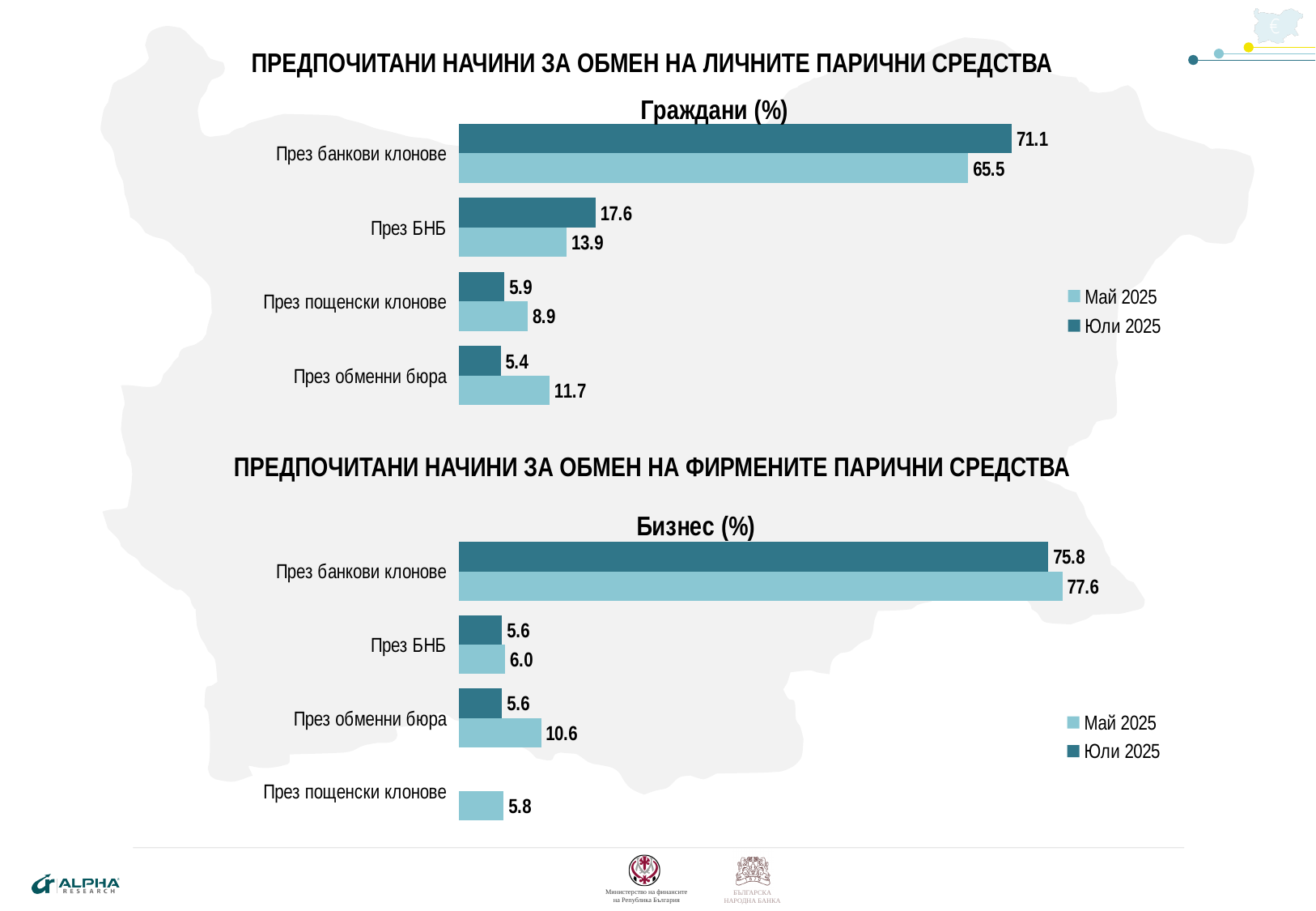
How many series does the legend of the "Бизнес (%)" chart list? 2 What kind of chart is the "Бизнес (%)" chart? Bar chart In the "Граждани (%)" chart, what is the value for "През банкови клонове" in Юли 2025? 71.1 In the "Граждани (%)" chart, which category has the highest value for Юли 2025? През банкови клонове In the "Граждани (%)" chart, which is larger for "През пощенски клонове": Май 2025 or Юли 2025? Май 2025 In the "Бизнес (%)" chart, what is the value for "През банкови клонове" in Май 2025? 77.6 In the "Граждани (%)" chart, what is the value for "През обменни бюра" in Май 2025? 11.7 How many categories are shown in the "Граждани (%)" chart? 4 In the "Бизнес (%)" chart, what is the difference between the Май 2025 and Юли 2025 values for "През обменни бюра"? 5.0 In the "Бизнес (%)" chart, what is the value for "През пощенски клонове" in Май 2025? 5.8 In the "Граждани (%)" chart, which category has the lowest value for Юли 2025? През обменни бюра In the "Граждани (%)" chart, what is the difference between the Юли 2025 and Май 2025 values for "През БНБ"? 3.7